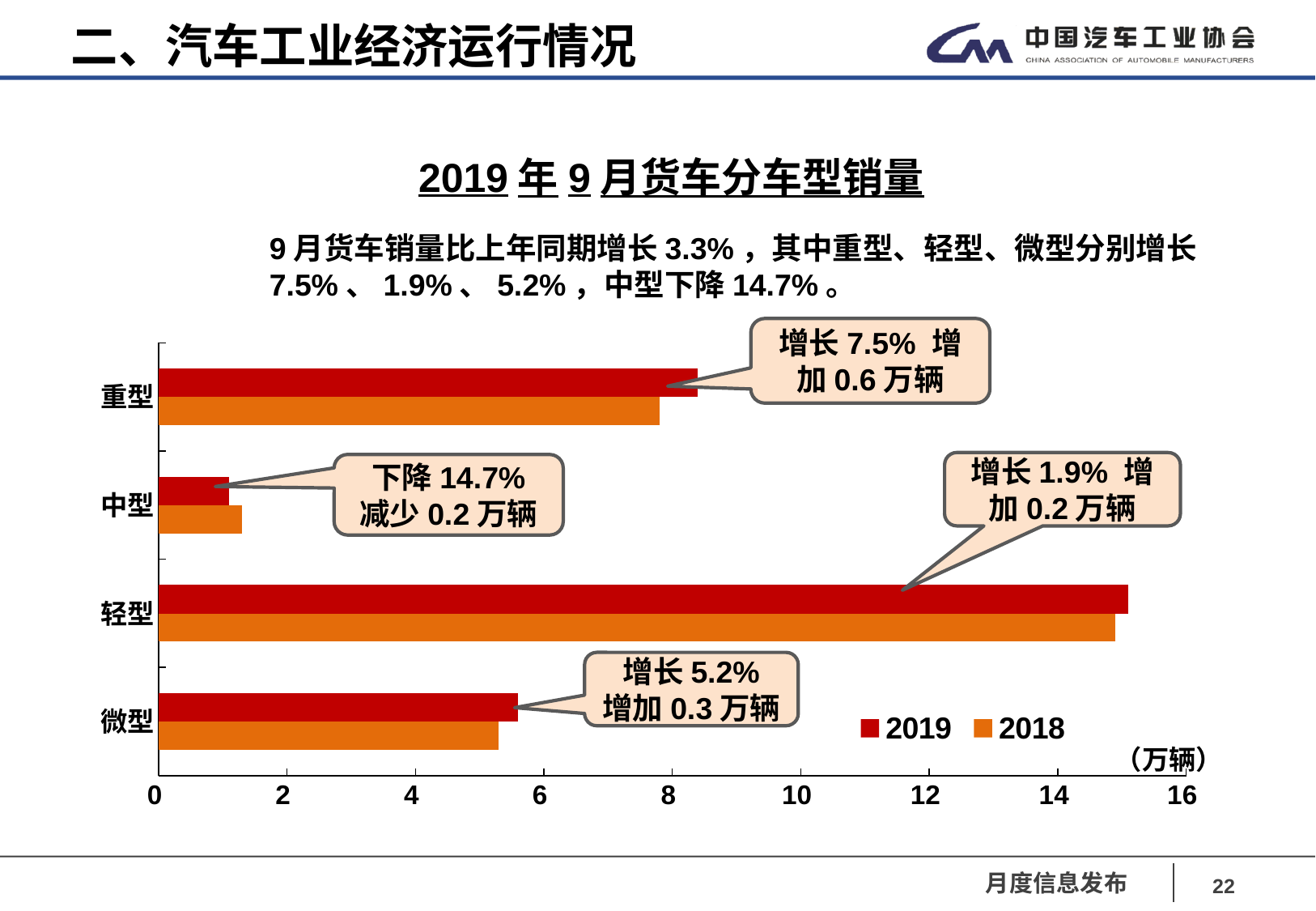
For 重型, which year has the larger bar, 2019 or 2018? 2019 Which category has the highest 2019 sales in the chart? 轻型 How many truck categories are shown on the y axis of the chart? 4 What kind of chart is shown on the slide? bar chart What is the title of the chart? 2019年9月货车分车型销量 Which category has the lowest 2019 sales in the chart? 中型 Is the 2018 value for 微型 greater or less than 6? less Is the 2019 value for 重型 greater or less than 8? greater How many series does the chart legend list? 2 Is the 2019 value for 轻型 greater or less than 14? greater For 中型, which year has the larger bar, 2019 or 2018? 2018 According to the callout on the chart, by what percentage did 中型 truck sales change? 下降 14.7%